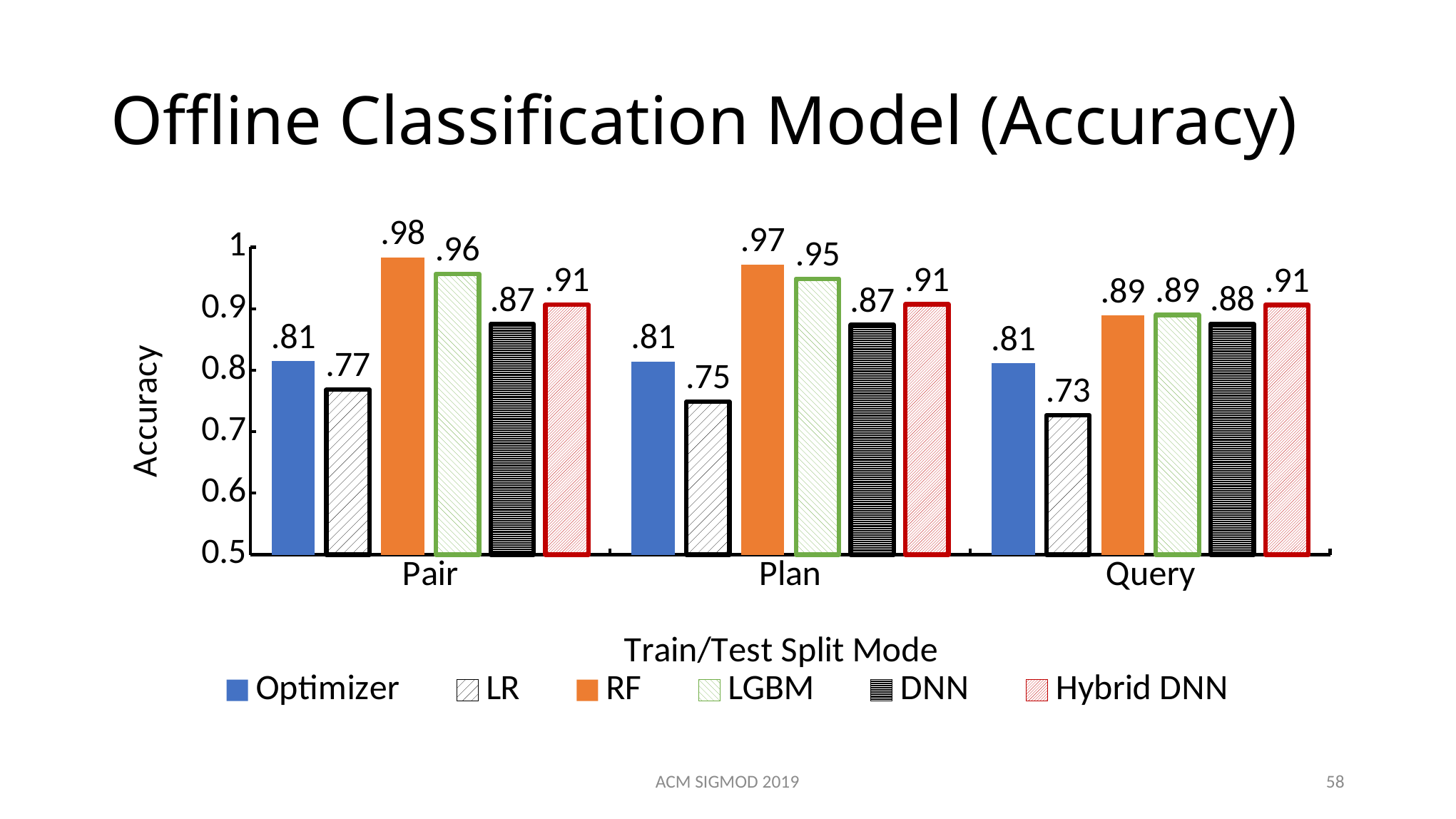
How does the LR accuracy change across the split modes from Pair to Query? It falls What is the accuracy of RF for the Pair split mode? .98 Which series has the lowest accuracy for the Query split mode? LR What is the label of the y axis? Accuracy Which series has the highest accuracy for the Plan split mode? RF How many train/test split modes are shown on the x axis? 3 What is the accuracy of Hybrid DNN for the Plan split mode? .91 What is the accuracy of LR for the Query split mode? .73 What kind of chart is shown on the slide? Bar chart Which is larger for the Query split mode, the accuracy of Optimizer or of DNN? DNN How many series does the legend list? 6 What is the difference between the RF and LR accuracies for the Pair split mode? .21